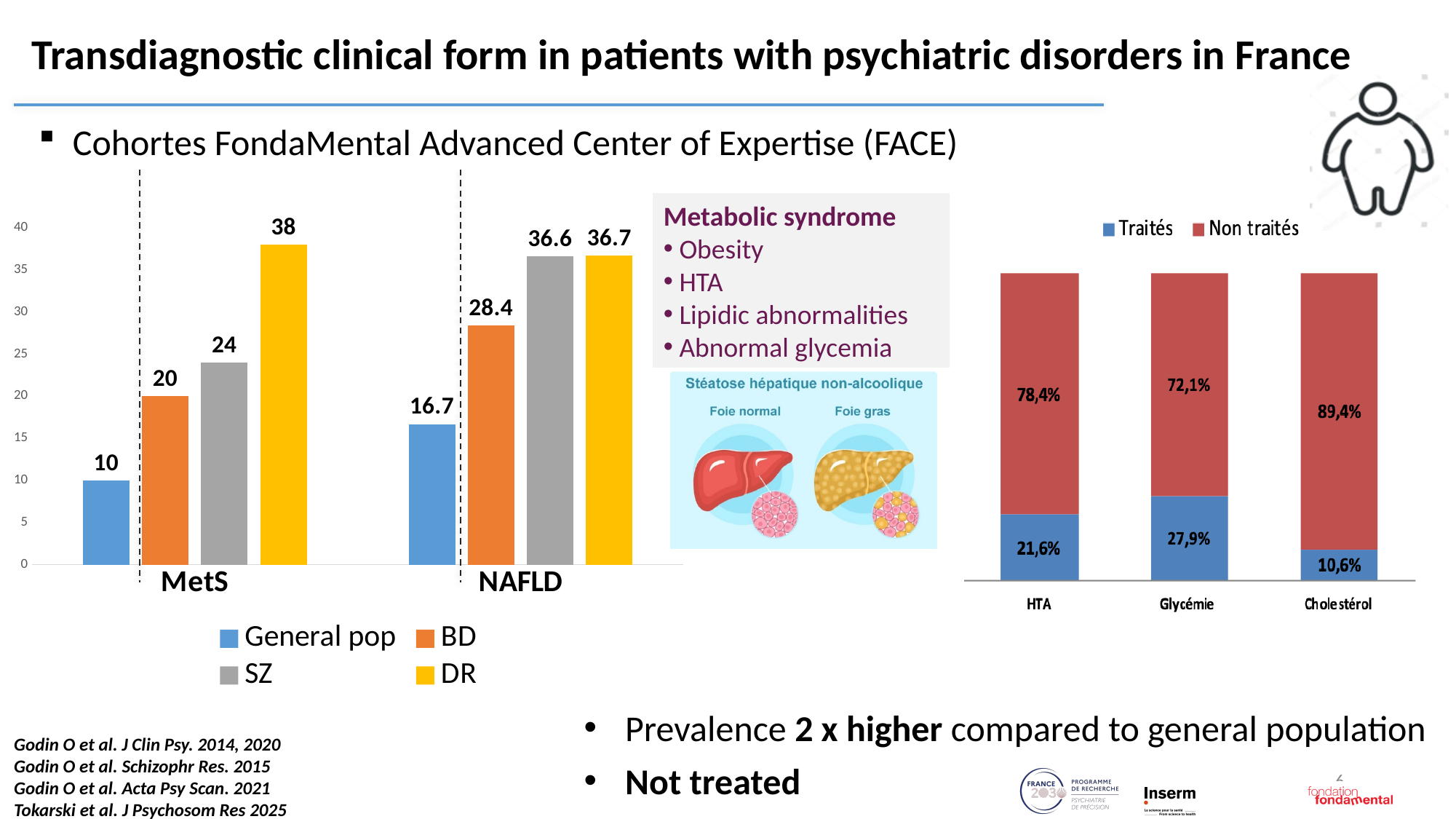
In the right stacked bar chart, how many categories are shown on the x axis? 3 In the left bar chart, which is larger in the NAFLD group: BD or SZ? SZ In the right stacked bar chart, what is the Non traités share for Cholestérol? 89,4% In the left bar chart, what is the value for DR in the MetS group? 38 In the left bar chart, what is the difference between the BD and General pop values in the MetS group? 10 In the right stacked bar chart, which category has the lowest Traités share? Cholestérol What kind of chart is the chart on the left of the slide? Bar chart In the left bar chart, what is the value for General pop in the NAFLD group? 16.7 In the right stacked bar chart, what colour represents Non traités? Red In the right stacked bar chart, what is the Traités share for Glycémie? 27,9% In the left bar chart, how many series does the legend list? 4 In the left bar chart, which series has the lowest value in the MetS group? General pop